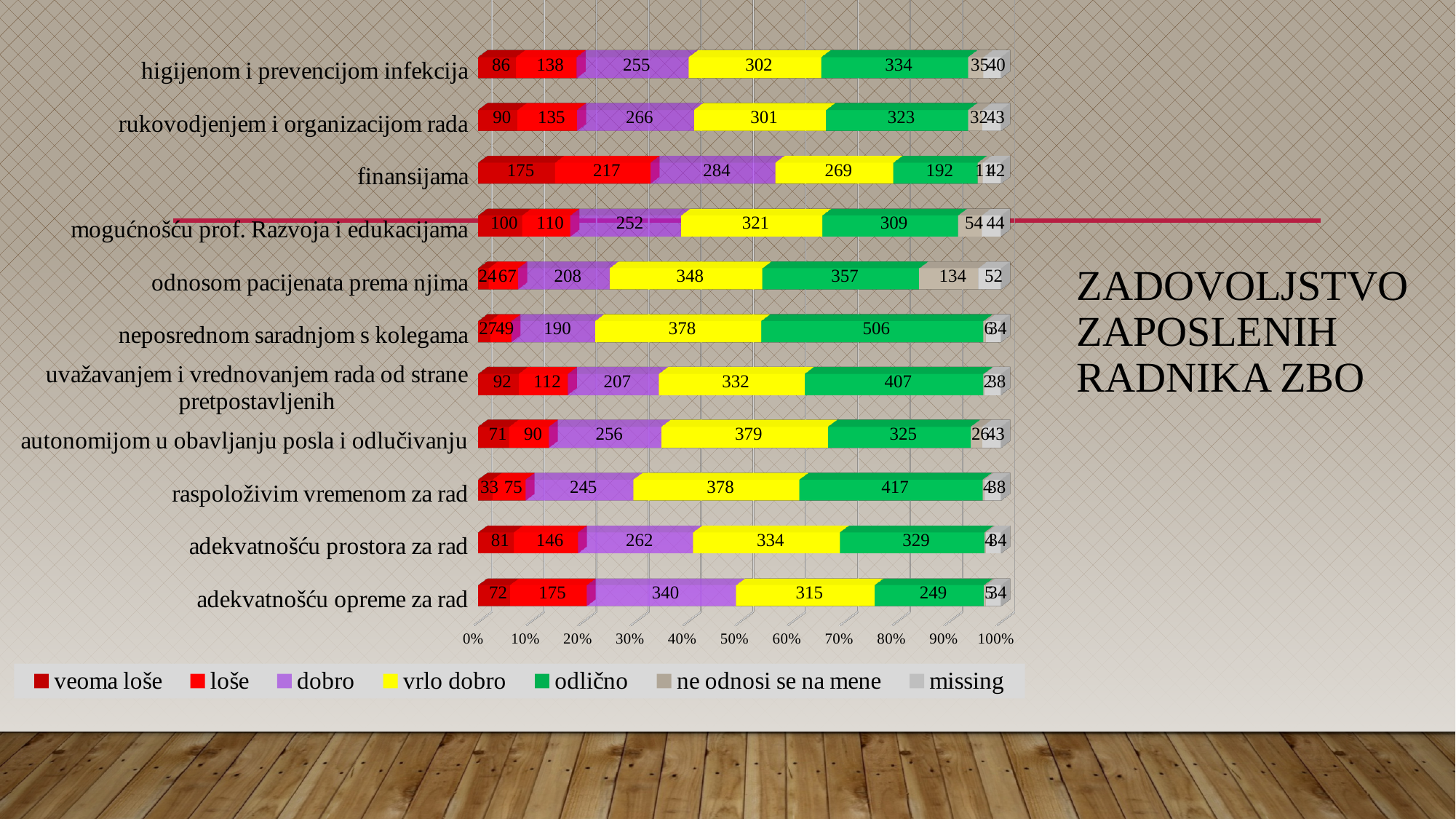
What kind of chart is shown on the slide? stacked bar chart What is the 'vrlo dobro' value for 'autonomijom u obavljanju posla i odlučivanju'? 379 Which legend entry is shown in yellow? vrlo dobro What is the 'dobro' value for 'adekvatnošću opreme za rad'? 340 Which is larger: the 'vrlo dobro' value for 'odnosom pacijenata prema njima' or for 'adekvatnošću prostora za rad'? odnosom pacijenata prema njima How many series does the chart legend list? 7 What is the difference between the 'loše' values for 'finansijama' and 'higijenom i prevencijom infekcija'? 79 What is the 'odlično' value for 'neposrednom saradnjom s kolegama'? 506 How many categories are plotted on the vertical axis of the chart? 11 Which category has the lowest 'odlično' value? finansijama What is the 'veoma loše' value for 'finansijama'? 175 Which category has the highest 'odlično' value? neposrednom saradnjom s kolegama